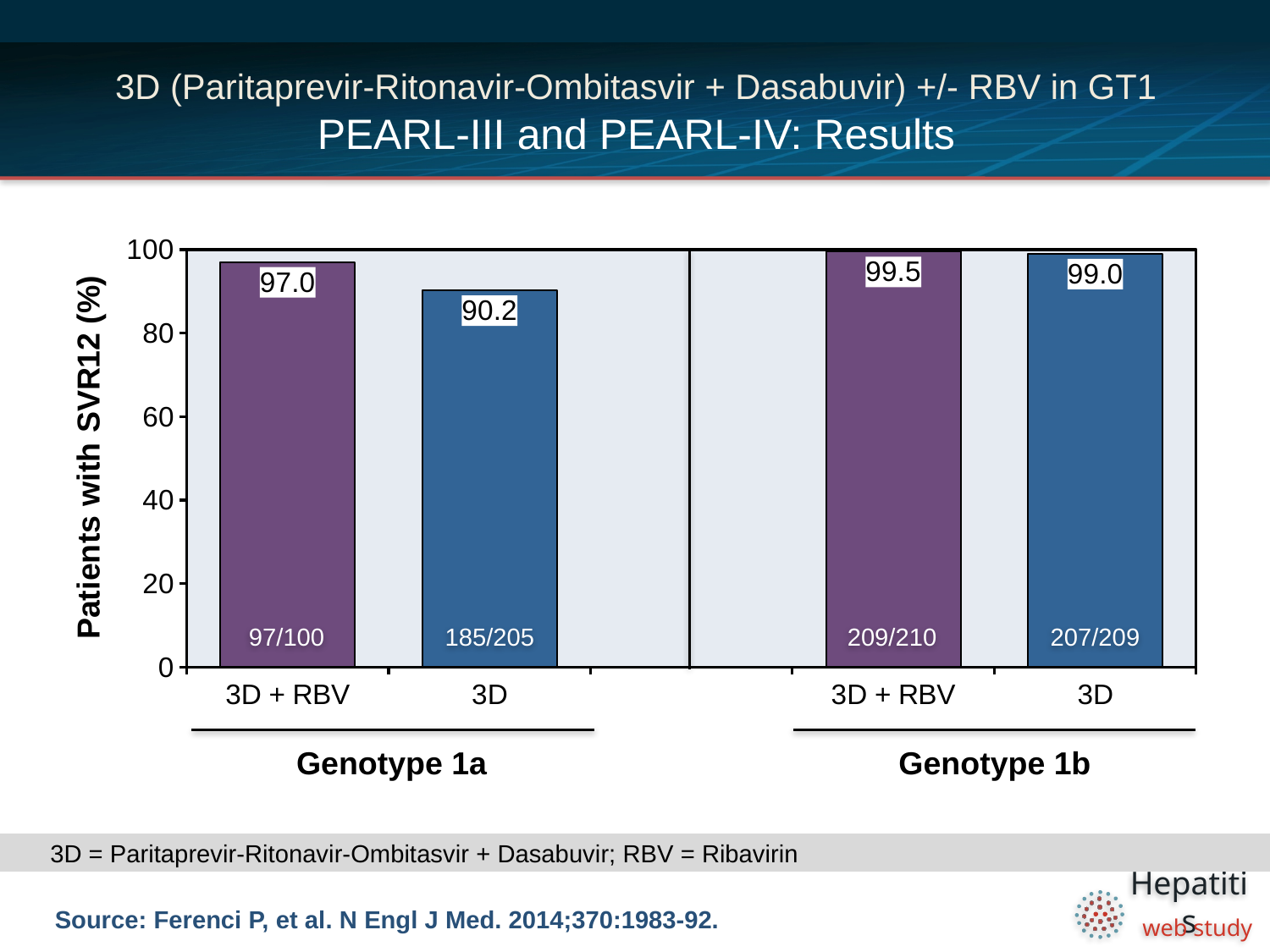
What type of chart is shown on the slide? Bar chart What is the SVR12 rate for 3D alone in Genotype 1b? 99.0 What is the difference in SVR12 rate between 3D + RBV and 3D in Genotype 1b? 0.5 Which bar has the highest SVR12 rate? 3D + RBV in Genotype 1b Which has a higher SVR12 rate in Genotype 1a, 3D + RBV or 3D? 3D + RBV What is the SVR12 rate for 3D + RBV in Genotype 1a? 97.0 Which bar has the lowest SVR12 rate? 3D in Genotype 1a How many bars are shown in the chart? 4 What fraction of patients is shown for the 3D + RBV bar in Genotype 1b? 209/210 What fraction of patients is shown for the 3D bar in Genotype 1a? 185/205 What is the difference in SVR12 rate between 3D + RBV and 3D in Genotype 1a? 6.8 What is the label of the y axis? Patients with SVR12 (%)